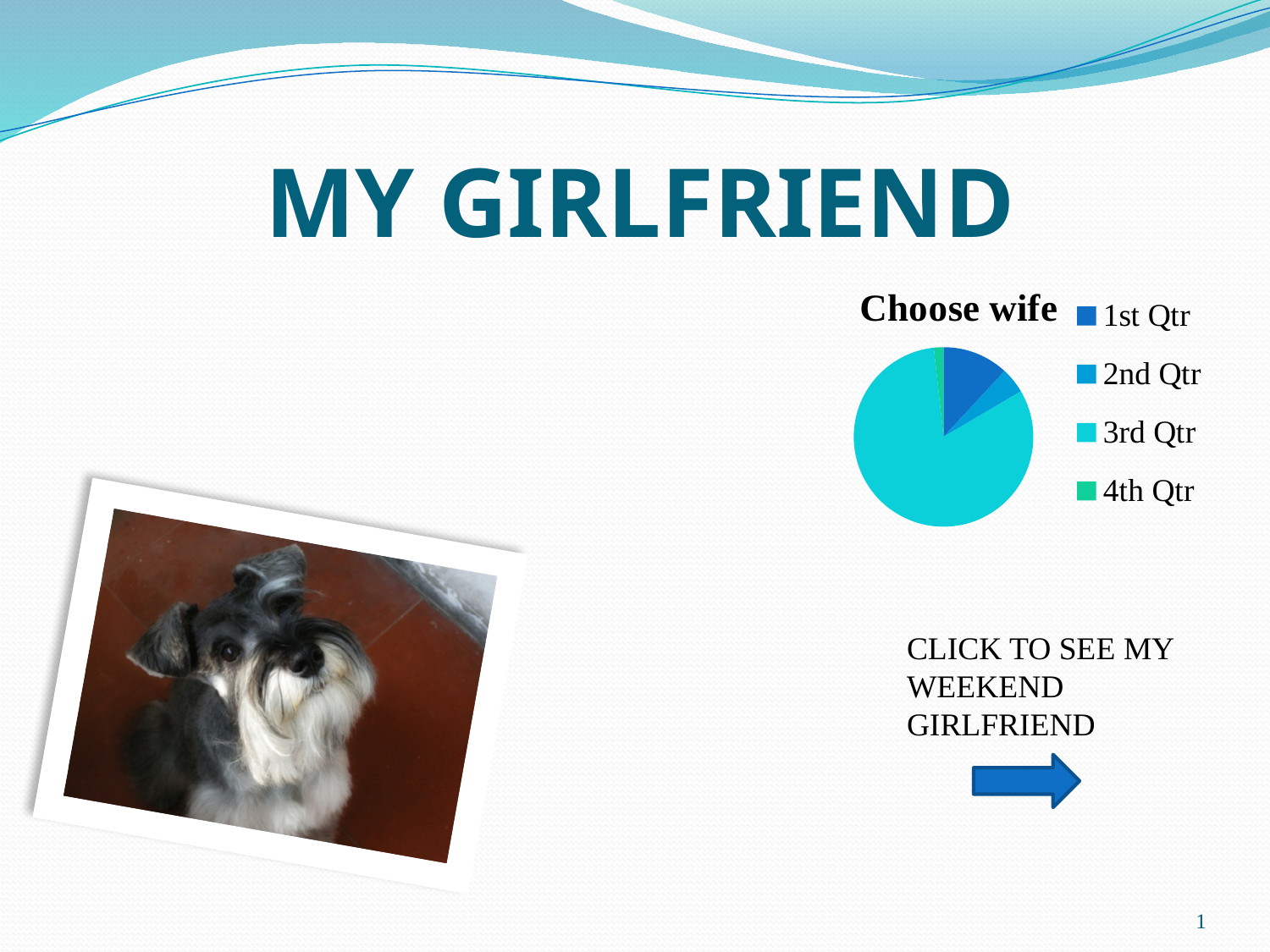
Which slice is larger in the pie chart, 1st Qtr or 4th Qtr? 1st Qtr Which category has the smallest slice in the pie chart? 4th Qtr Which slice is larger in the pie chart, 3rd Qtr or 1st Qtr? 3rd Qtr Which legend entry is listed first in the pie chart's legend? 1st Qtr What is the title of the pie chart? Choose wife What kind of chart is shown on the slide? pie chart How many entries does the legend of the pie chart list? 4 Which slice is larger in the pie chart, 2nd Qtr or 3rd Qtr? 3rd Qtr Which category has the largest slice in the pie chart? 3rd Qtr How many slices does the pie chart have? 4